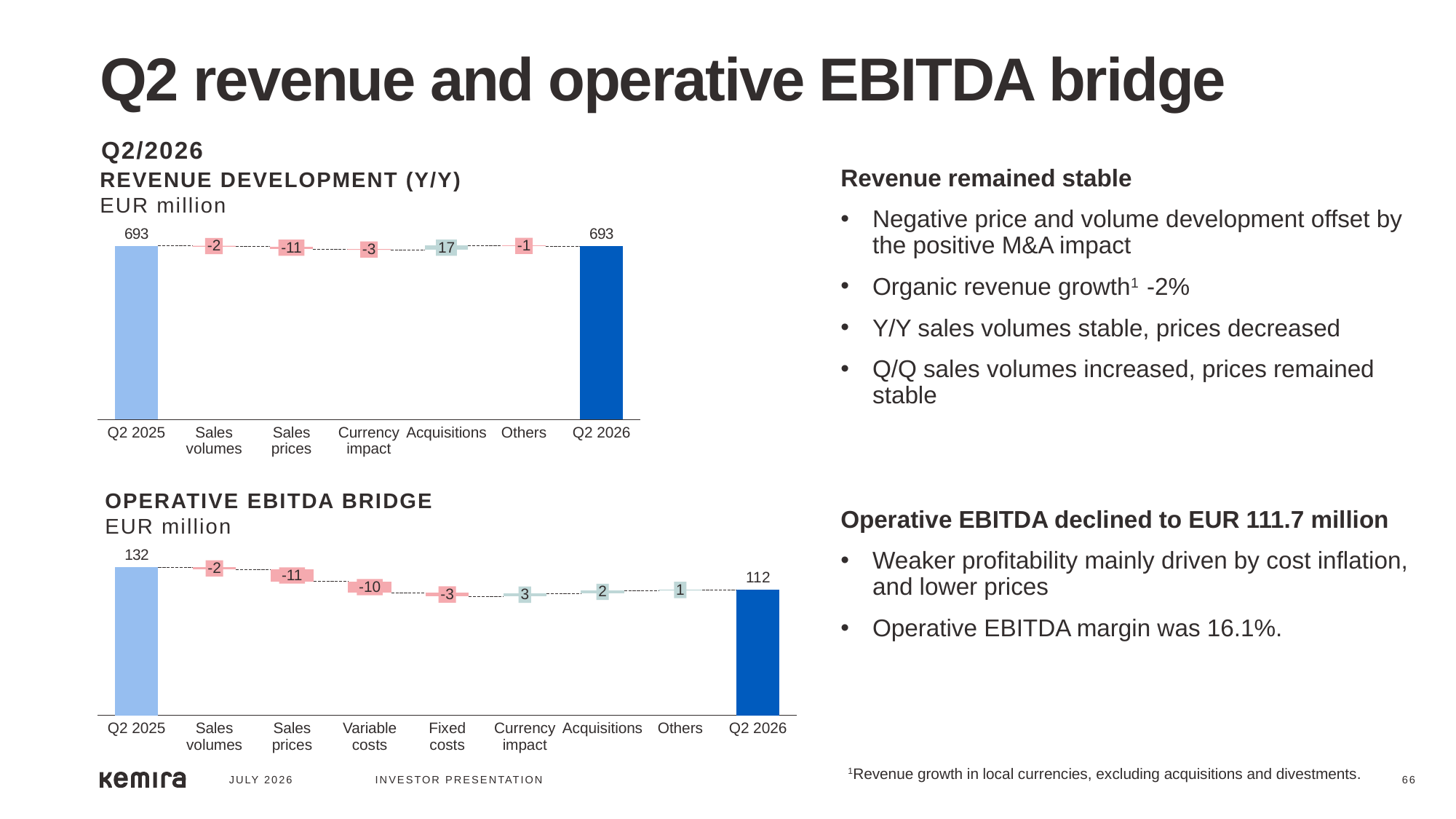
In the Revenue development chart, what is the value for Sales prices? -11 In the Operative EBITDA bridge chart, which is larger, the value for Acquisitions or the value for Others? Acquisitions In the Revenue development chart, what is the value for Q2 2025? 693 In the Revenue development chart, how many categories are shown on the x axis? 7 In the Operative EBITDA bridge chart, what is the value for Currency impact? 3 What kind of chart is the Operative EBITDA bridge chart? Bar chart (waterfall) In the Revenue development chart, what is the value for Acquisitions? 17 In the Operative EBITDA bridge chart, what is the value for Q2 2026? 112 In the Operative EBITDA bridge chart, what is the difference between the Q2 2025 and Q2 2026 values? 20 In the Operative EBITDA bridge chart, how many categories are shown on the x axis? 9 In the Operative EBITDA bridge chart, what is the value for Variable costs? -10 In the Revenue development chart, what is the difference between the Q2 2025 and Q2 2026 values? 0